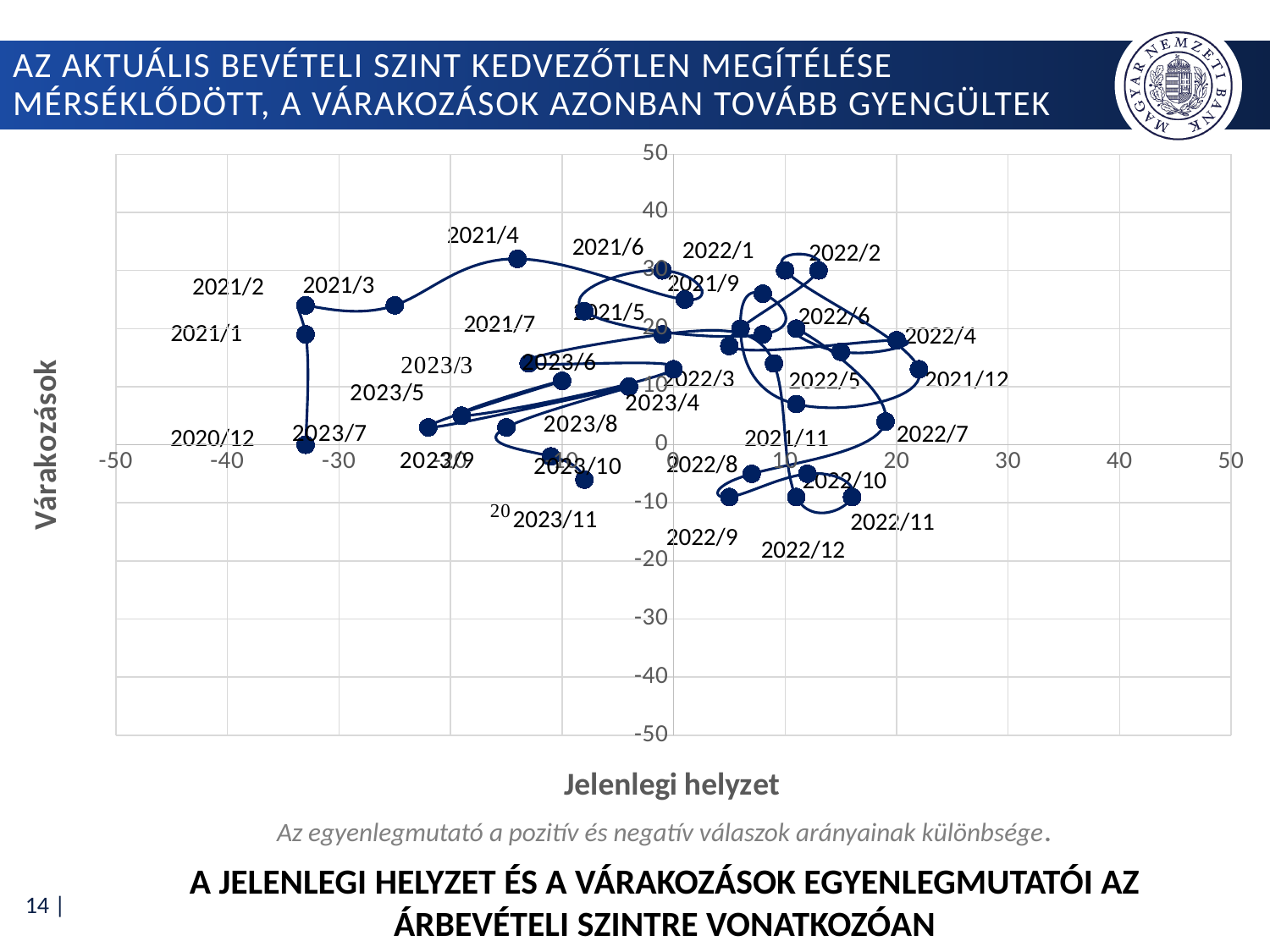
Is the Várakozások value for 2022/12 greater or less than 0? less What kind of chart is shown on the slide? scatter chart What is the title of the horizontal axis of the chart? Jelenlegi helyzet Is the Várakozások value for 2023/11 greater or less than 0? less Is the Jelenlegi helyzet value for 2022/4 greater or less than 10? greater What is the title of the vertical axis of the chart? Várakozások Which point has the higher Jelenlegi helyzet value, 2021/1 or 2022/4? 2022/4 Which point has the higher Várakozások value, 2021/4 or 2022/12? 2021/4